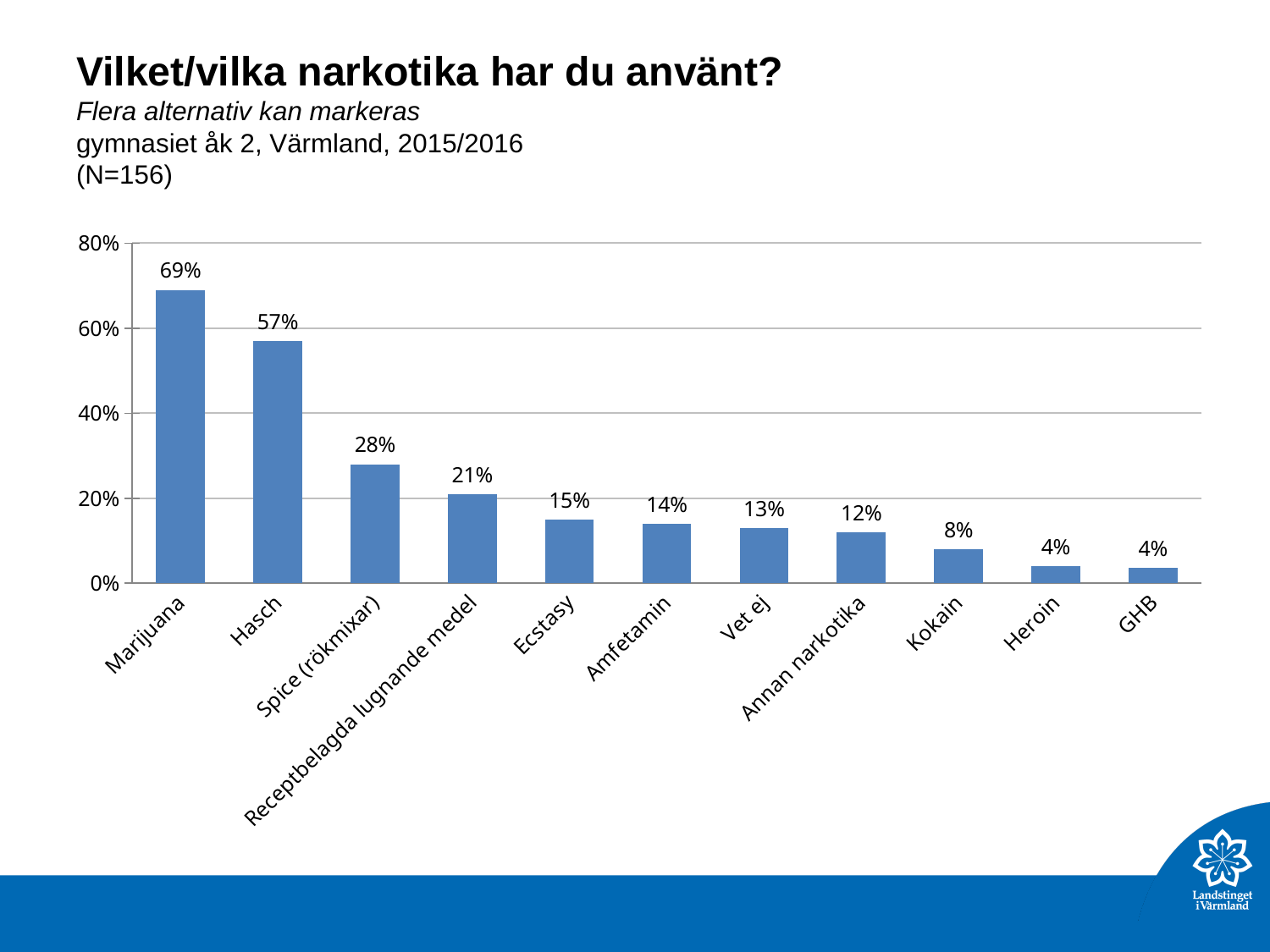
What is the value for Spice (rökmixar)? 28% What kind of chart is shown on the slide? bar chart What is the title of the chart on the slide? Vilket/vilka narkotika har du använt? What is the value for Marijuana? 69% Which category has the highest value? Marijuana What is the difference between the values for Marijuana and Hasch? 12% How many categories are shown on the x axis? 11 What is the value for Receptbelagda lugnande medel? 21% What is the value for Kokain? 8% Which is larger, the value for Ecstasy or the value for Amfetamin? Ecstasy Do the values rise or fall from left to right along the x axis? fall Is the value for Hasch greater or less than 60%? less